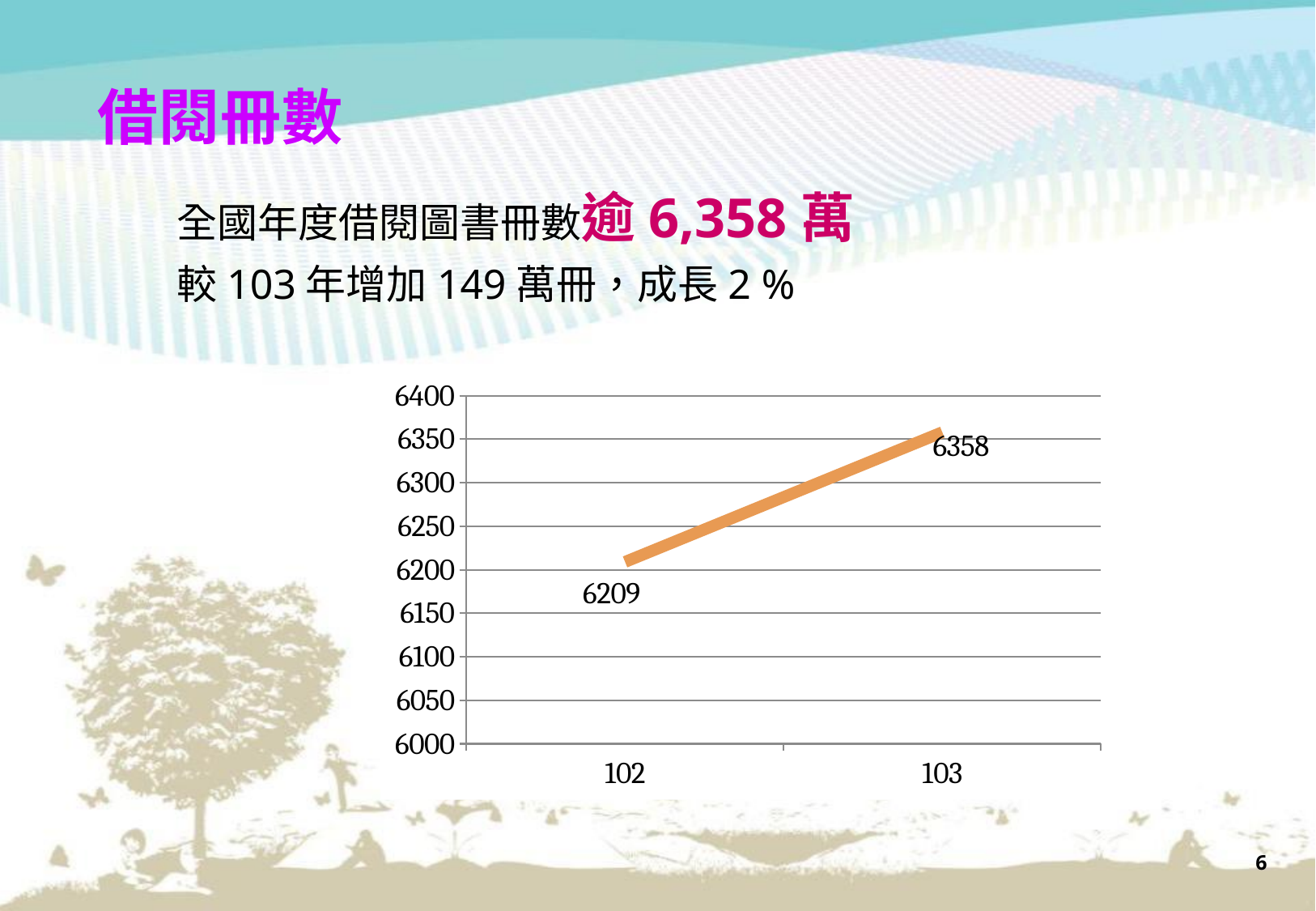
Which year has the lowest value on the chart? 102 How many data points are plotted on the chart? 2 Which year has the higher value, 102 or 103? 103 What is the value plotted for year 103? 6358 Is the value for 102 greater or less than 6250? less Do the values rise or fall from 102 to 103? rise What colour is the line in the chart? orange Is the value for 103 greater or less than 6300? greater What is the difference between the values for 103 and 102? 149 What is the value plotted for year 102? 6209 What kind of chart is shown on the slide? line chart What is the maximum value shown on the vertical axis? 6400